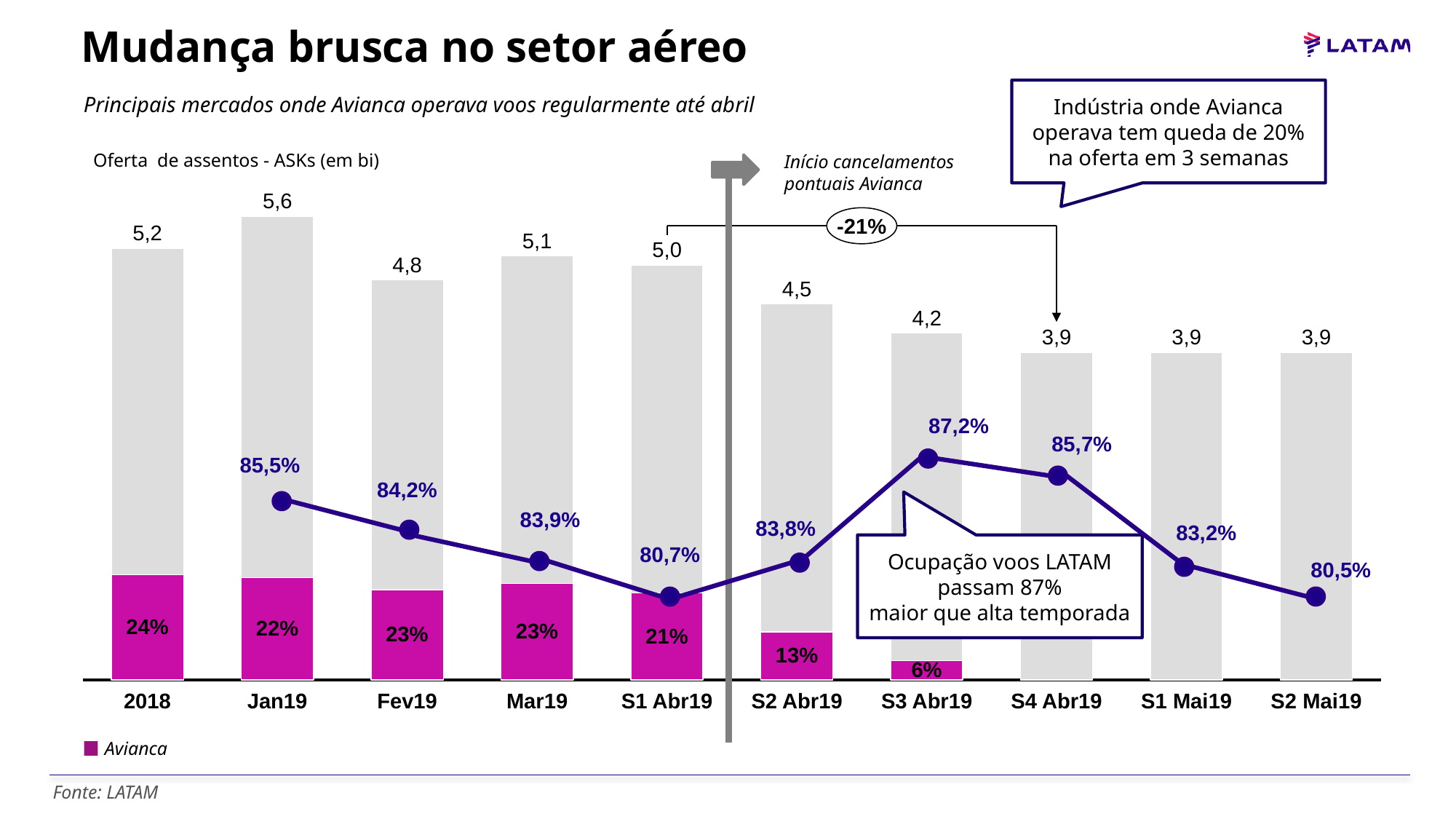
What is the seat offer (ASKs, em bi) value shown for Jan19? 5,6 Which has a larger seat offer (ASKs): Fev19 or Mar19? Mar19 Does the occupancy line rise or fall from S3 Abr19 to S2 Mai19? Fall What occupancy percentage is shown on the line for S1 Abr19? 80,7% Which period has the highest occupancy value on the line? S3 Abr19 Which period has the highest seat offer (ASKs) bar? Jan19 How many periods are shown on the x axis? 10 What occupancy percentage is shown on the line for S3 Abr19? 87,2% What Avianca share is labelled on the bar for S2 Abr19? 13% What is the difference in seat offer (ASKs) between S1 Abr19 and S4 Abr19? 1,1 Which period has the lowest labelled Avianca share? S3 Abr19 What kind of chart is shown on the slide? Bar chart with a line